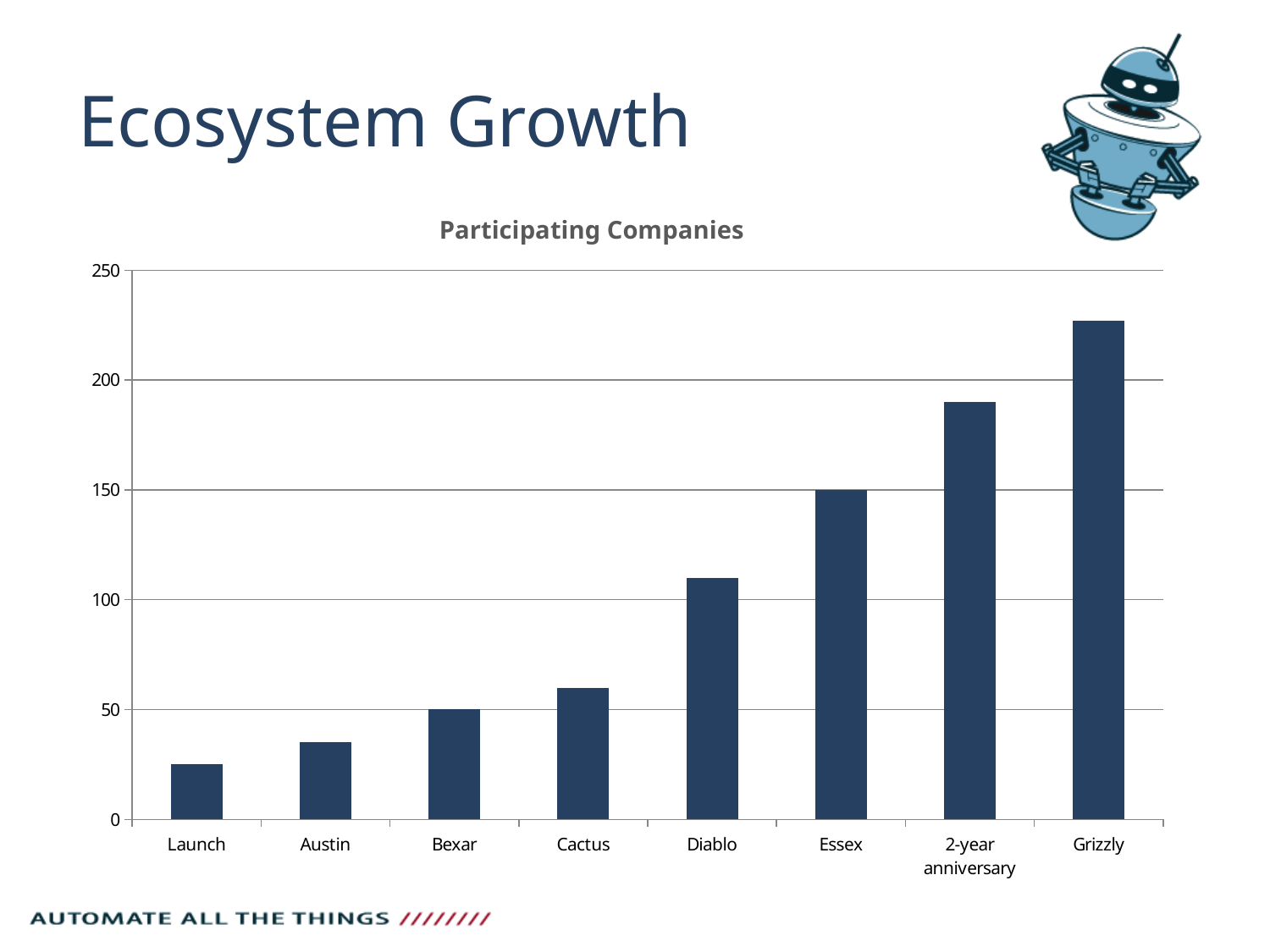
What kind of chart is shown on the slide? bar chart Which category has the highest value? Grizzly Is the value for Diablo greater or less than 100? greater What is the value for Bexar? 50 What is the value for Essex? 150 How many categories are shown on the x axis? 8 Do the values rise or fall from Launch to Grizzly along the x axis? rise Which category has the lowest value? Launch What is the title of the chart? Participating Companies Is the value for Grizzly greater or less than 200? greater Is the value for Launch greater or less than 50? less Which is larger, the value for Cactus or the value for Diablo? Diablo